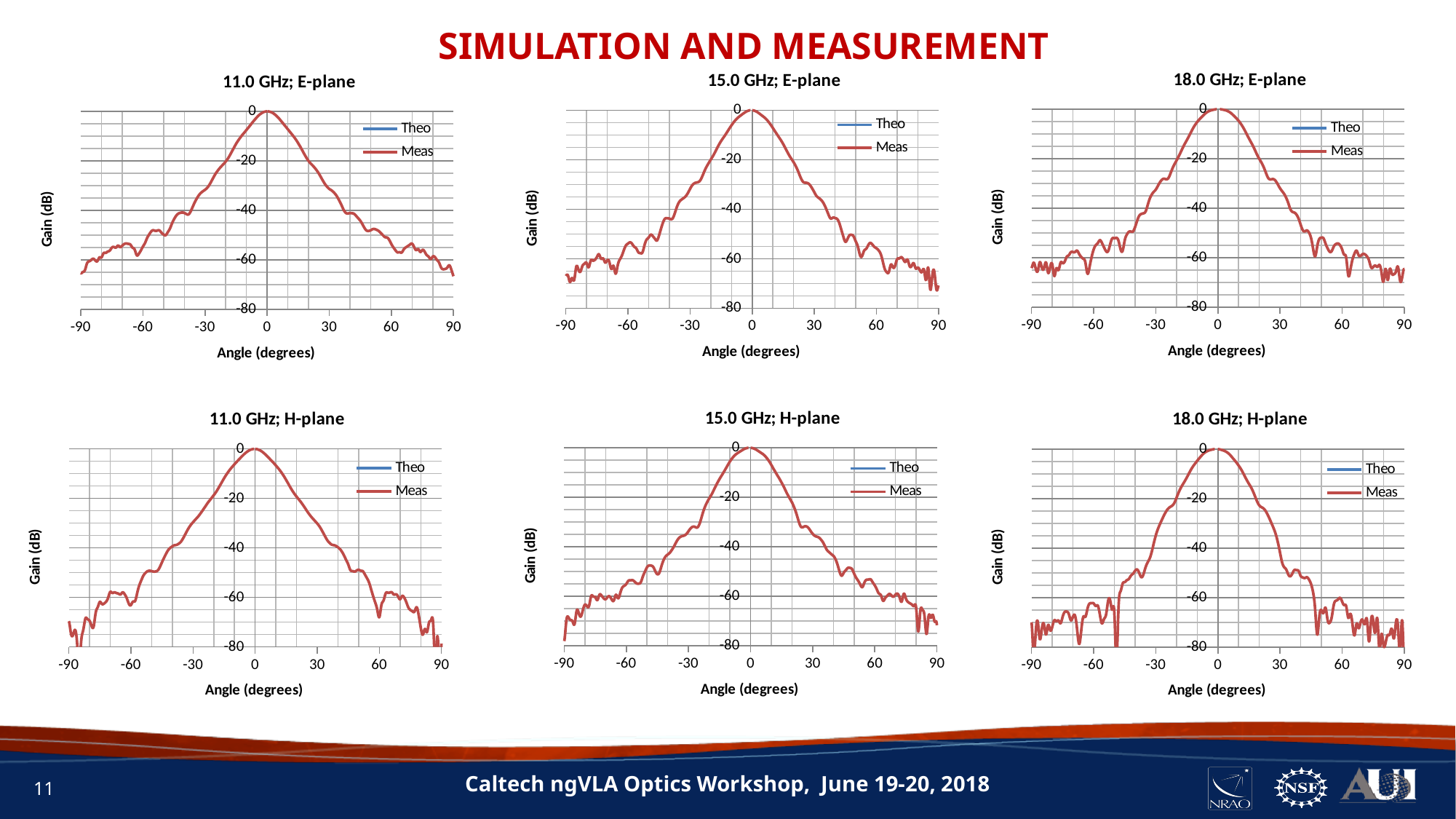
In the "15.0 GHz; E-plane" chart, what is the gain at an angle of 0 degrees? 0 dB In the "11.0 GHz; E-plane" chart, at what angle does the gain reach its highest value? 0 degrees How many series does the legend of the "15.0 GHz; H-plane" chart list? 2 In the "18.0 GHz; E-plane" chart, is the gain at -60 degrees greater or less than -40 dB? less What are the two legend entries in the "18.0 GHz; E-plane" chart? Theo and Meas In the "18.0 GHz; H-plane" chart, is the gain at 30 degrees greater or less than -60 dB? greater How many charts are shown on the slide? 6 What kind of chart is the "11.0 GHz; E-plane" chart? line chart In the "11.0 GHz; H-plane" chart, which angle has the larger gain, 30 degrees or 60 degrees? 30 degrees In the "11.0 GHz; E-plane" chart, is the gain at 60 degrees greater or less than -40 dB? less What is the y-axis label of the "11.0 GHz; H-plane" chart? Gain (dB) In the "15.0 GHz; H-plane" chart, does the gain rise or fall as the angle increases from 0 to 90 degrees? fall